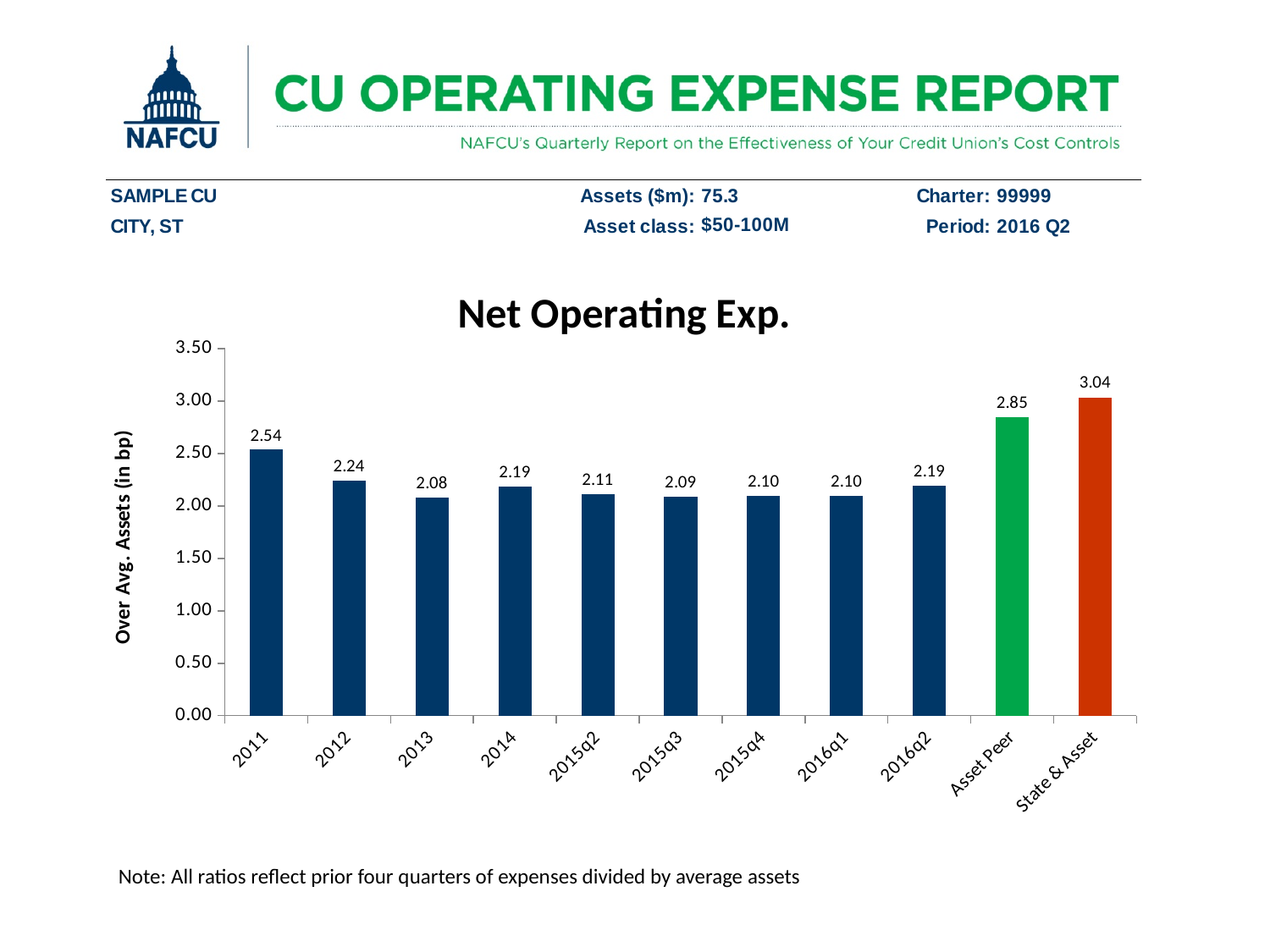
Is the value for Asset Peer greater or less than 3.00 in the Net Operating Exp. chart? less Which category has the highest value in the Net Operating Exp. chart? State & Asset What is the value for Asset Peer in the Net Operating Exp. chart? 2.85 What is the value for 2015q3 in the Net Operating Exp. chart? 2.09 Which is larger in the Net Operating Exp. chart, the value for 2012 or the value for 2014? 2012 How many bars are shown in the Net Operating Exp. chart? 11 What is the value for 2011 in the Net Operating Exp. chart? 2.54 What is the y-axis label of the Net Operating Exp. chart? Over Avg. Assets (in bp) What colour is the State & Asset bar in the Net Operating Exp. chart? red What is the difference between the State & Asset value and the 2016q2 value in the Net Operating Exp. chart? 0.85 What kind of chart is the Net Operating Exp. chart? bar chart Which category has the lowest value in the Net Operating Exp. chart? 2013